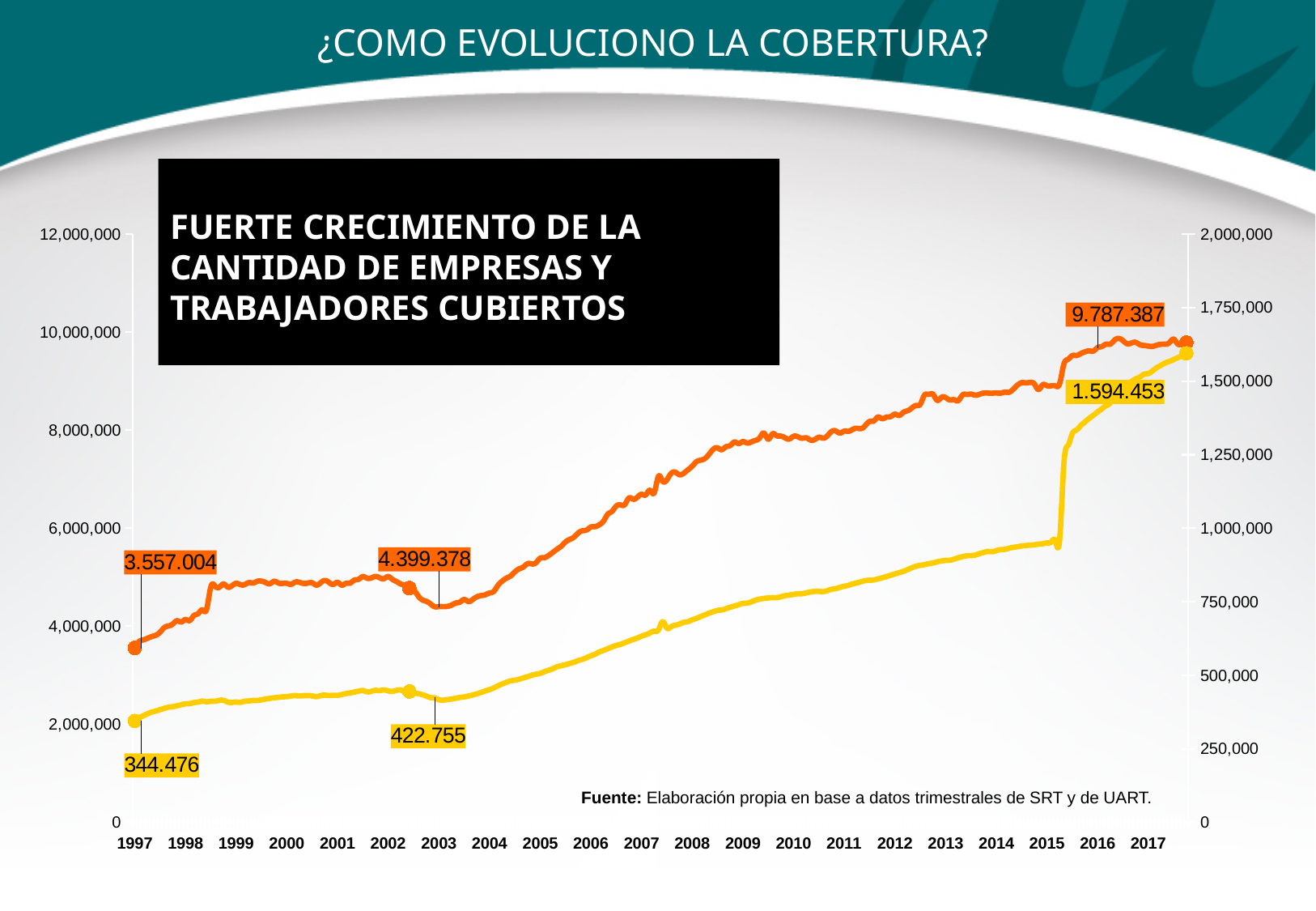
What is the first labelled value of the orange line, at 1997? 3.557.004 What type of chart is shown on the slide? line chart What is the labelled value of the yellow line around 2003? 422.755 How many year labels are shown on the x axis? 21 Which labelled value of the orange line is larger: the one around 2003 or the one at 2017? 2017 (9.787.387) What is the first labelled value of the yellow line, at 1997? 344.476 What is the last labelled value of the yellow line, at 2017? 1.594.453 What is the last labelled value of the orange line, at 2017? 9.787.387 Is the value of the orange line in 2010, read on the left axis, greater or less than 6,000,000? greater Do the two lines generally rise or fall from 1997 to 2017? rise What is the labelled value of the orange line around 2003? 4.399.378 By how much did the orange line's labelled value increase from 1997 (3.557.004) to 2017 (9.787.387)? 6.230.383